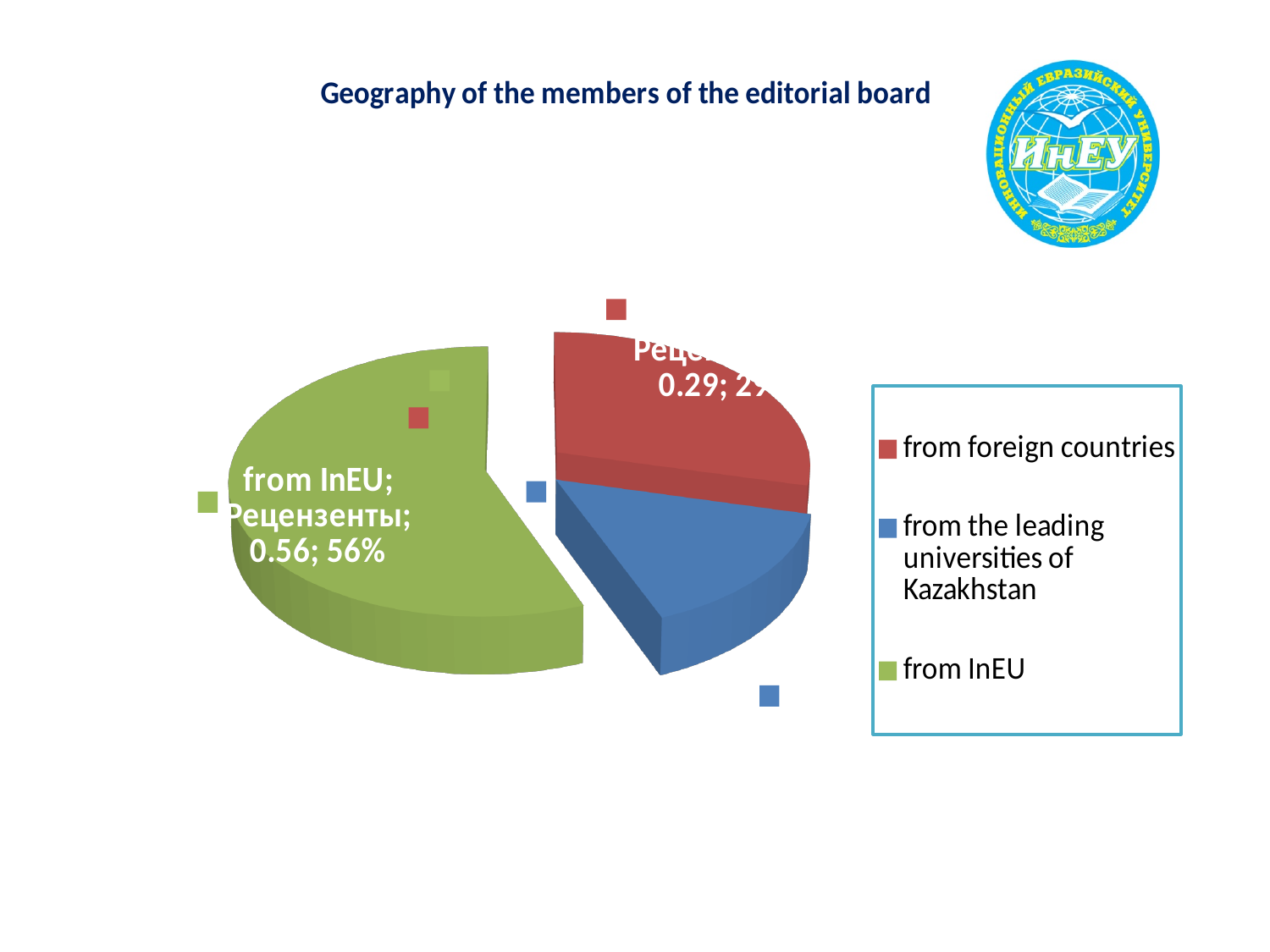
What percentage share of the pie is labelled for 'from InEU'? 56% Which category has the smallest slice of the pie? from the leading universities of Kazakhstan What colour is the 'from InEU' slice in the pie chart? green How many categories does the legend of the pie chart list? 3 Which category has the largest slice of the pie? from InEU What value is printed on the red 'from foreign countries' slice? 0.29 Is the share for 'from InEU' greater or less than 50%? greater What kind of chart is shown on the slide? pie chart What is the difference between the printed values for 'from InEU' (0.56) and 'from foreign countries' (0.29)? 0.27 Which slice is larger: 'from InEU' or 'from foreign countries'? from InEU What value is printed on the 'from InEU' slice before the percentage? 0.56 What is the title of the chart? Geography of the members of the editorial board